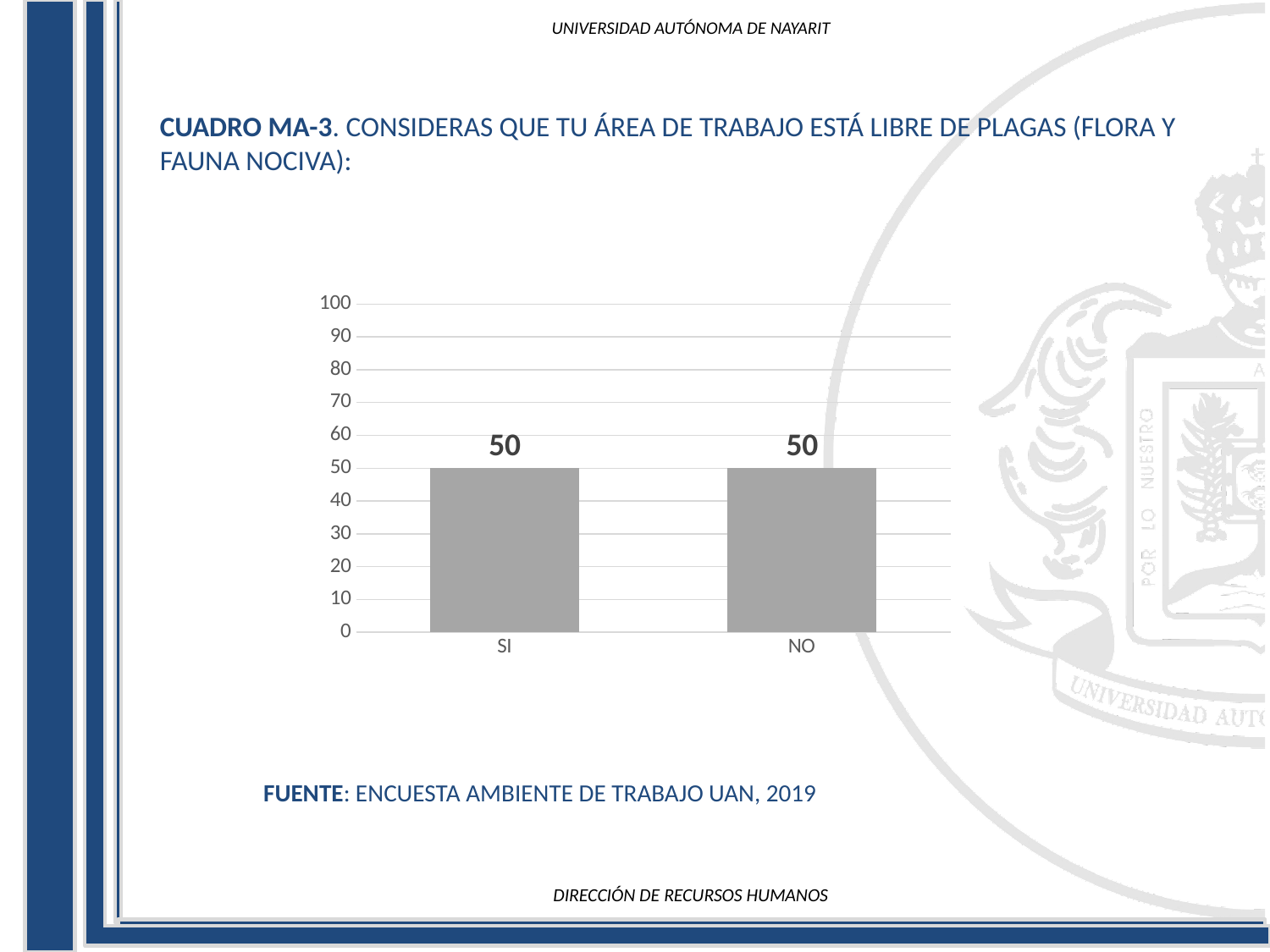
How many categories are shown on the x axis? 2 What is the total of the values for SI and NO? 100 Is the value for SI greater or less than 60? less What kind of chart is shown? bar chart What is the value for SI? 50 Are the values for SI and NO equal? Yes Is the value for NO greater or less than 40? greater What is the source cited below the chart? ENCUESTA AMBIENTE DE TRABAJO UAN, 2019 What is the difference between the values for SI and NO? 0 What is the value for NO? 50 What is the maximum value shown on the y axis? 100